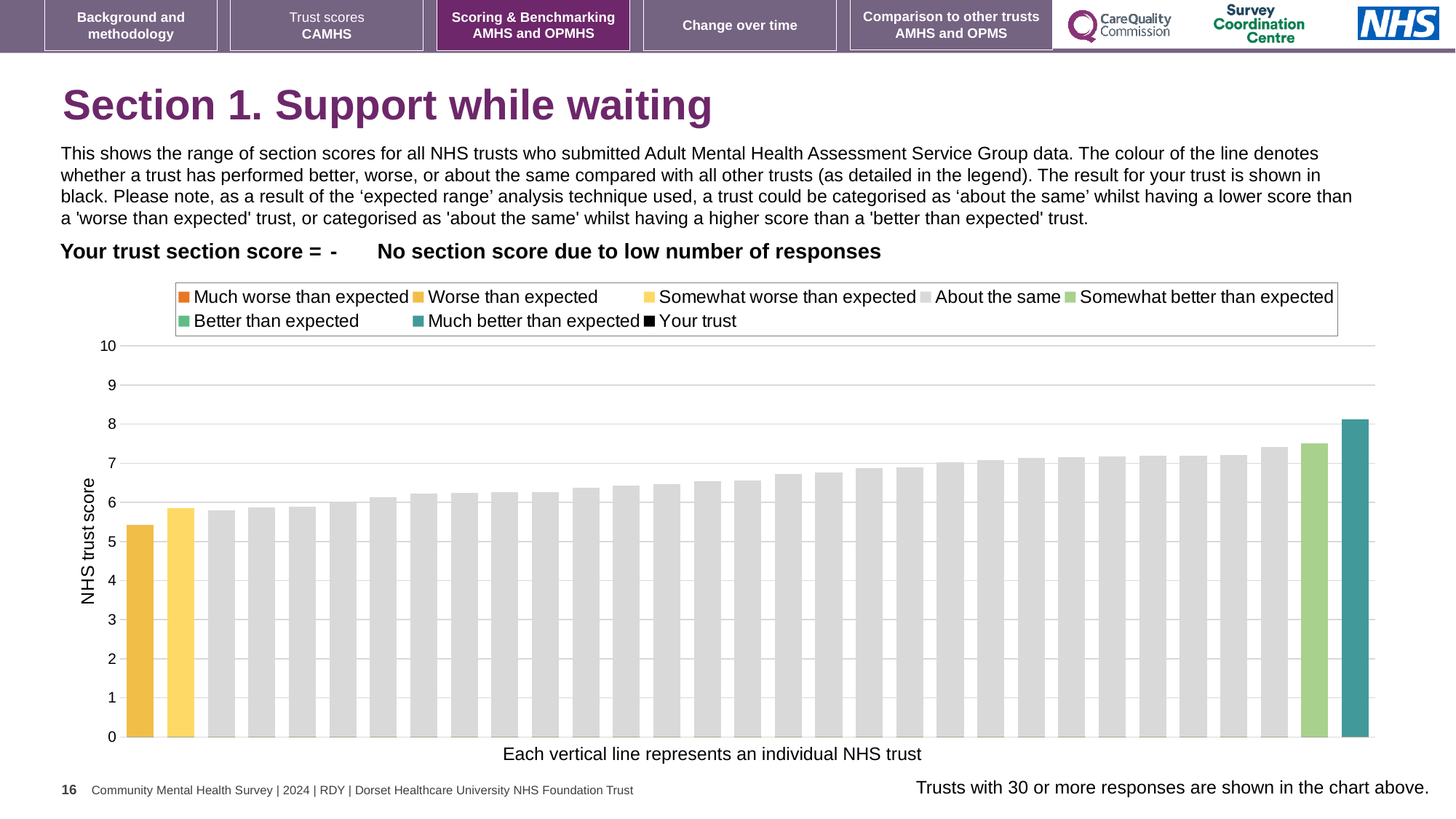
Which legend category does the tallest bar belong to? Much better than expected Do the bar values rise or fall from left to right along the x axis? rise What kind of chart is shown on the slide? bar chart Which legend category does the shortest bar belong to? Worse than expected What is the highest value shown on the vertical axis? 10 Is the value of the leftmost bar greater or less than 5? greater Which bar is the tallest: the leftmost bar or the rightmost bar? the rightmost bar What is the label on the vertical axis of the chart? NHS trust score How many entries does the chart legend list? 8 Is the value of the leftmost bar greater or less than 6? less Is the value of the rightmost bar greater or less than 7? greater